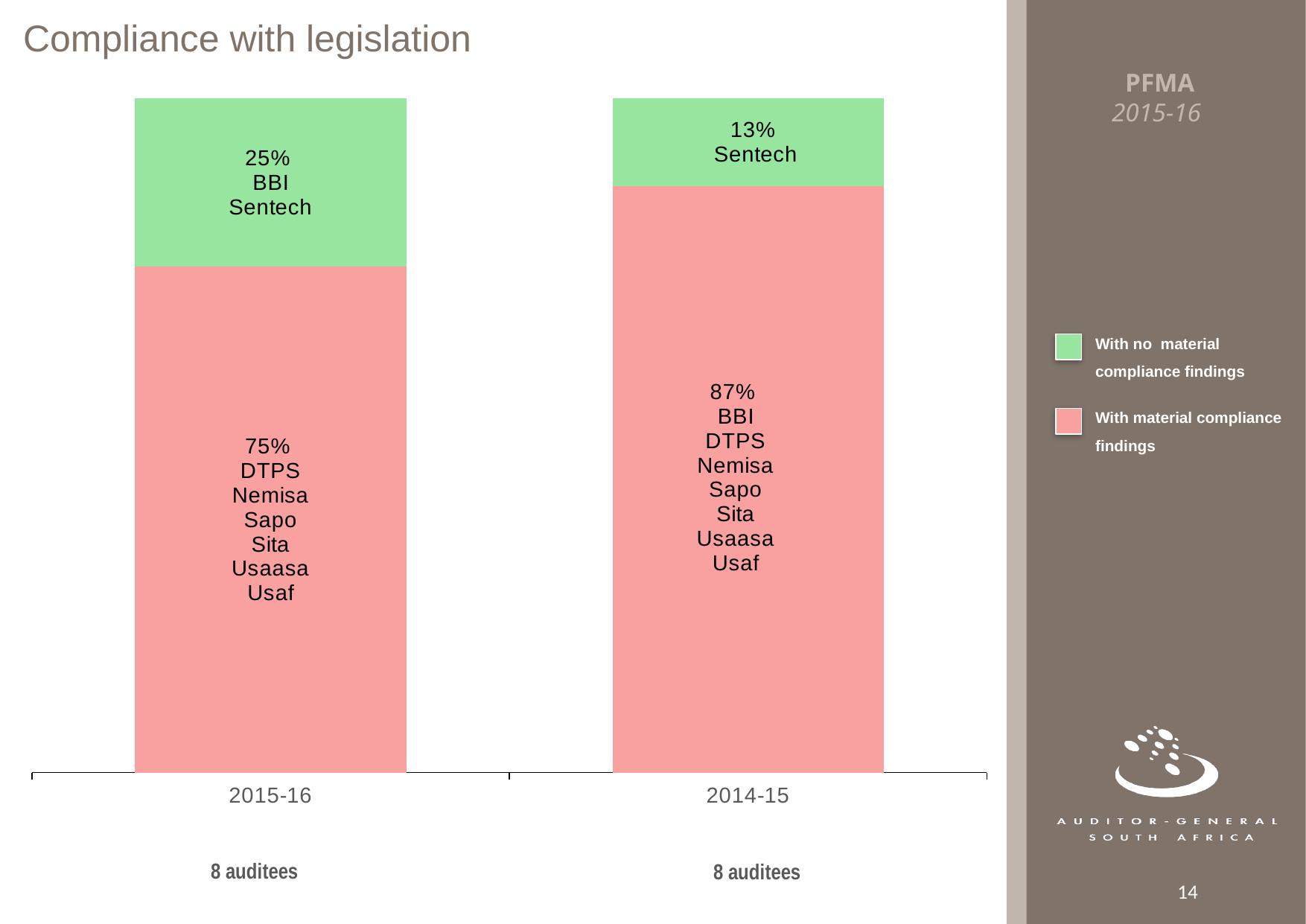
What percentage of auditees had no material compliance findings in 2014-15? 13% Which auditee is named in the 'With no material compliance findings' segment for 2014-15? Sentech How many series does the legend list? 2 How many categories (years) are shown on the x axis? 2 What percentage of auditees had no material compliance findings in 2015-16? 25% What kind of chart is shown on the slide? Stacked bar chart Which year had the higher share of auditees with no material compliance findings? 2015-16 What colour represents 'With material compliance findings' in the legend? Red (pink) What percentage of auditees had material compliance findings in 2014-15? 87% How many auditees are noted below each bar? 8 auditees By how many percentage points did the share of auditees with material compliance findings fall from 2014-15 to 2015-16? 12 What percentage of auditees had material compliance findings in 2015-16? 75%